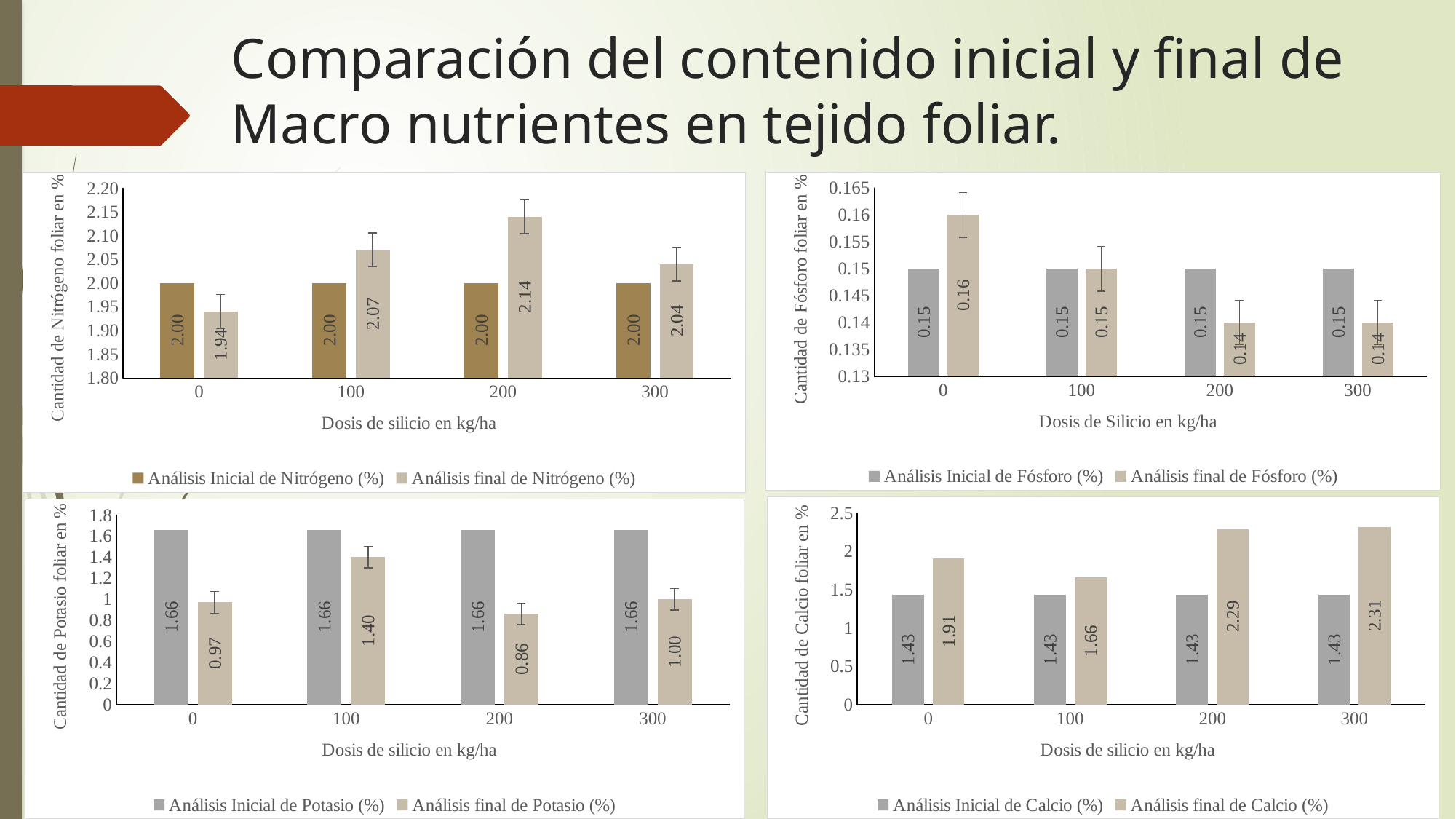
In the bottom-right chart (Calcio), what is the difference between Análisis final de Calcio (%) and Análisis Inicial de Calcio (%) at 200 kg/ha? 0.86 In the top-right chart (Fósforo), what is the value of Análisis final de Fósforo (%) at a silicon dose of 0 kg/ha? 0.16 In the bottom-left chart (Potasio), what is the value of Análisis final de Potasio (%) at a silicon dose of 100 kg/ha? 1.40 In the bottom-left chart (Potasio), which is larger at 0 kg/ha: Análisis Inicial de Potasio (%) or Análisis final de Potasio (%)? Análisis Inicial de Potasio (%) In the top-left chart (Nitrógeno), what is the difference between Análisis final de Nitrógeno (%) and Análisis Inicial de Nitrógeno (%) at 100 kg/ha? 0.07 In the bottom-right chart (Calcio), what is the value of Análisis final de Calcio (%) at a silicon dose of 300 kg/ha? 2.31 In the bottom-left chart (Potasio), at which silicon dose is Análisis final de Potasio (%) lowest? 200 In the top-left chart (Nitrógeno), what is the value of Análisis final de Nitrógeno (%) at a silicon dose of 200 kg/ha? 2.14 In the top-left chart (Nitrógeno), at which silicon dose is Análisis final de Nitrógeno (%) highest? 200 How many series does the legend of the top-left chart (Nitrógeno) list? 2 In the top-right chart (Fósforo), how many silicon dose categories are shown on the x axis? 4 In the bottom-right chart (Calcio), does Análisis final de Calcio (%) rise or fall as the silicon dose increases from 100 to 300 kg/ha? rise